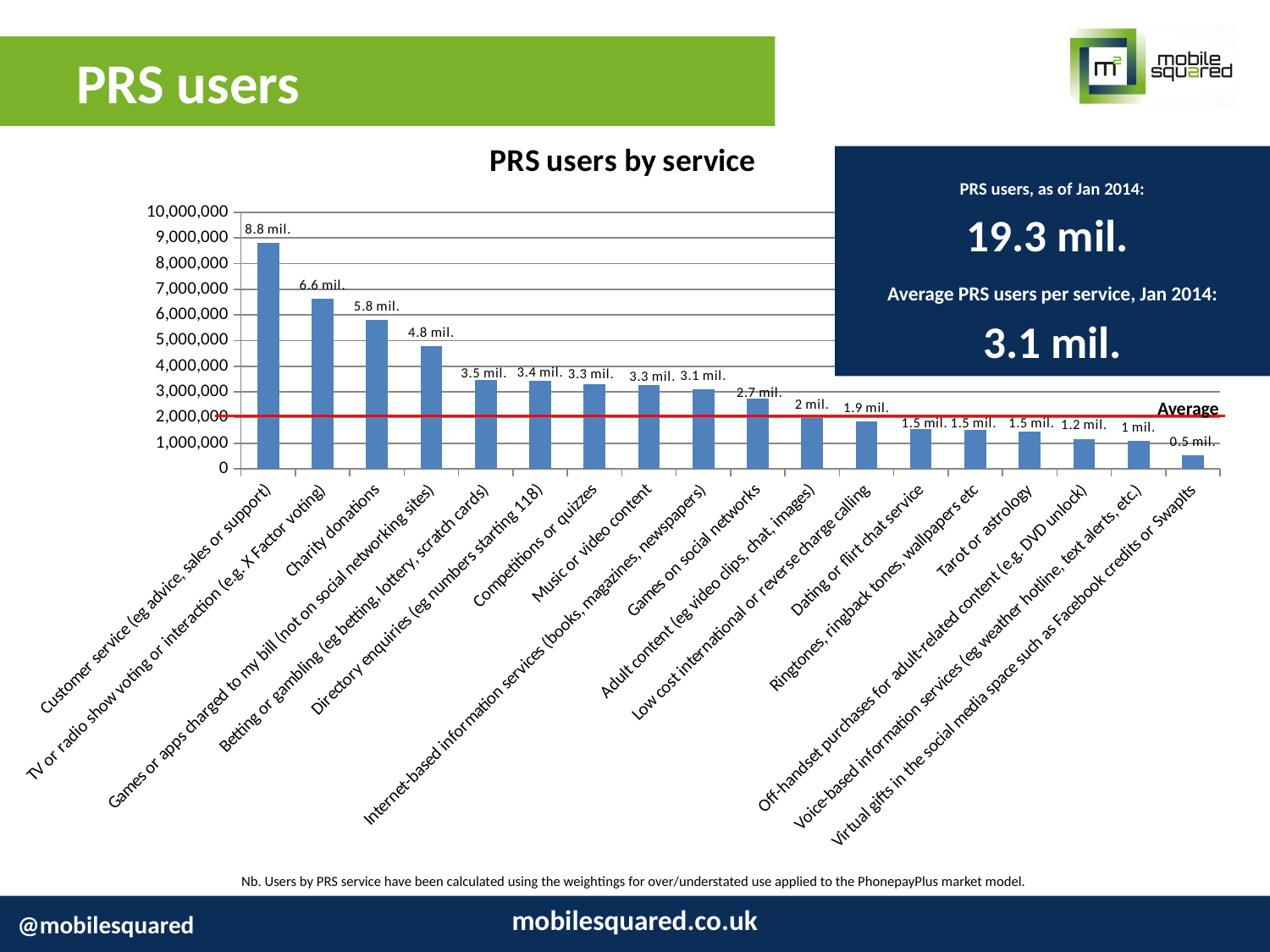
What is the value for Customer service (eg advice, sales or support)? 8.8 mil. What is the value for Charity donations? 5.8 mil. Which service has the highest number of PRS users? Customer service (eg advice, sales or support) What is the difference between the values for Customer service (eg advice, sales or support) and TV or radio show voting or interaction (e.g. X Factor voting)? 2.2 mil. What is the value for Games on social networks? 2.7 mil. What kind of chart is shown on the slide? Bar chart Which service has the lowest number of PRS users? Virtual gifts in the social media space such as Facebook credits or SwapIts Do the values rise or fall from left to right along the x axis? Fall What is the value for Tarot or astrology? 1.5 mil. How many service categories are shown in the chart? 18 Which is larger, the value for Charity donations or the value for Betting or gambling (eg betting, lottery, scratch cards)? Charity donations Is the value for Games or apps charged to my bill (not on social networking sites) greater or less than 4,000,000? greater